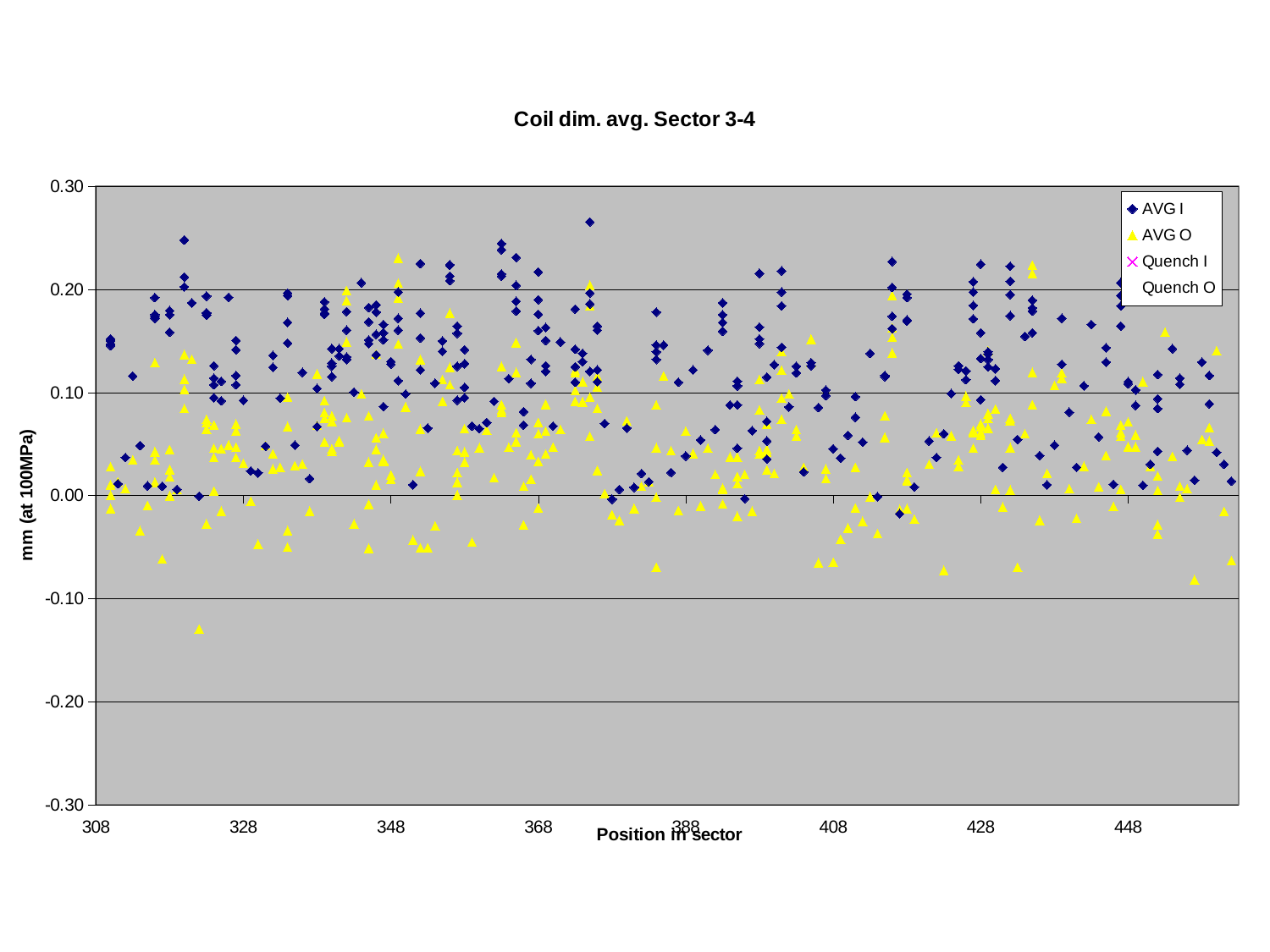
What is the title of the chart? Coil dim. avg. Sector 3-4 How many series does the legend list? 4 What is the label of the y axis? mm (at 100MPa) What is the minimum value shown on the y axis? -0.30 Which series contains the single highest plotted point, AVG I or AVG O? AVG I Is the highest AVG I value greater or less than 0.20? greater Which series contains the single lowest plotted point, AVG I or AVG O? AVG O What kind of chart is shown on the slide? Scatter chart Is the lowest AVG I value greater or less than -0.10? greater What is the maximum value shown on the y axis? 0.30 Is the lowest AVG O value greater or less than -0.10? less What is the first tick value shown on the x axis? 308